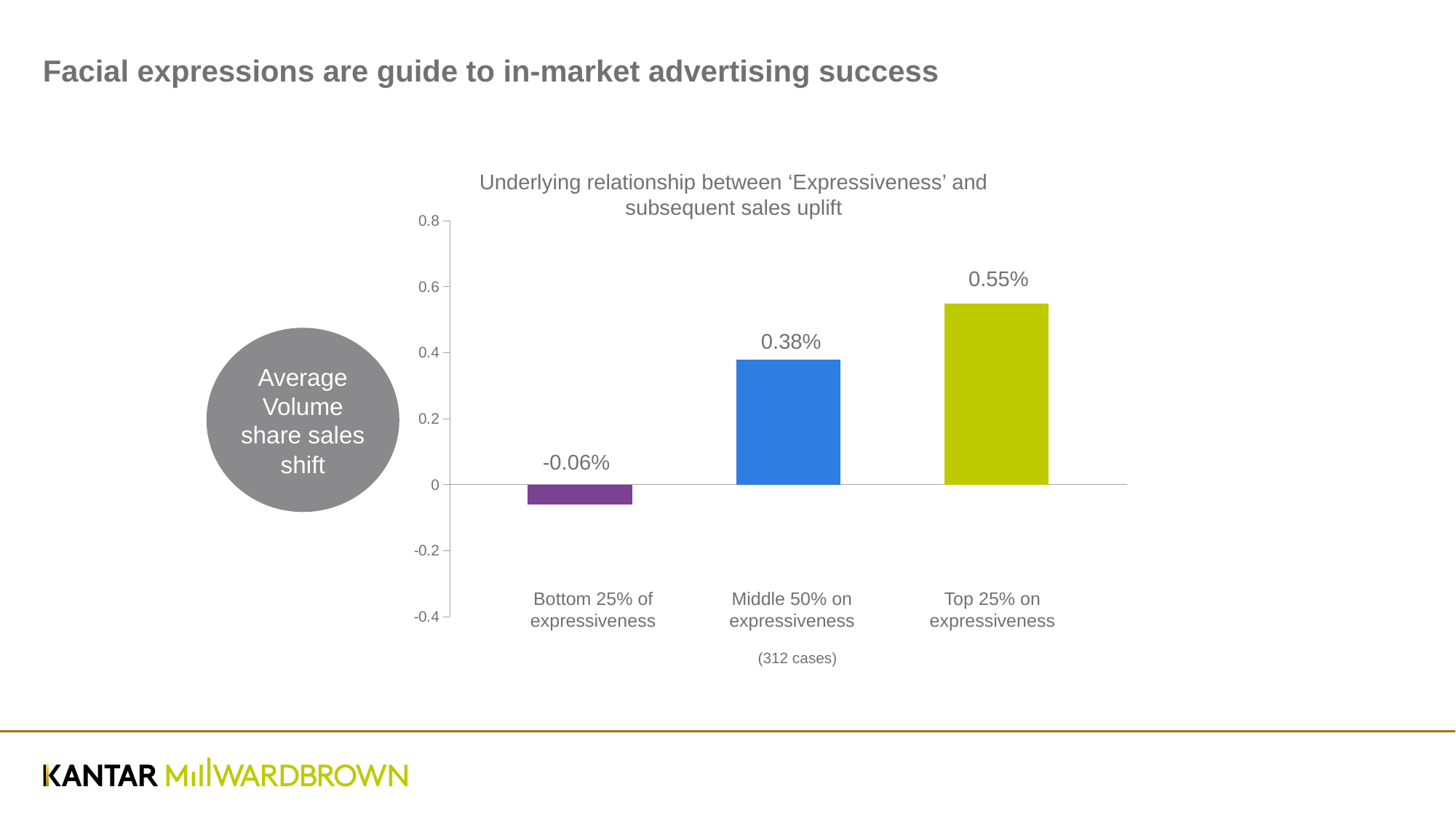
Do the values rise or fall from left to right across the categories? Rise How many categories are shown in the chart? 3 What is the title of the chart? Underlying relationship between ‘Expressiveness’ and subsequent sales uplift What is the value for Top 25% on expressiveness? 0.55% Which is larger, the value for Middle 50% on expressiveness or Bottom 25% of expressiveness? Middle 50% on expressiveness What is the value for Middle 50% on expressiveness? 0.38% What kind of chart is shown on the slide? Bar chart Which category has the lowest value? Bottom 25% of expressiveness What is the value for Bottom 25% of expressiveness? -0.06% Is the value for Top 25% on expressiveness greater or less than 0.4? greater Which category has the highest value? Top 25% on expressiveness What is the difference between the values for Top 25% on expressiveness and Middle 50% on expressiveness? 0.17%